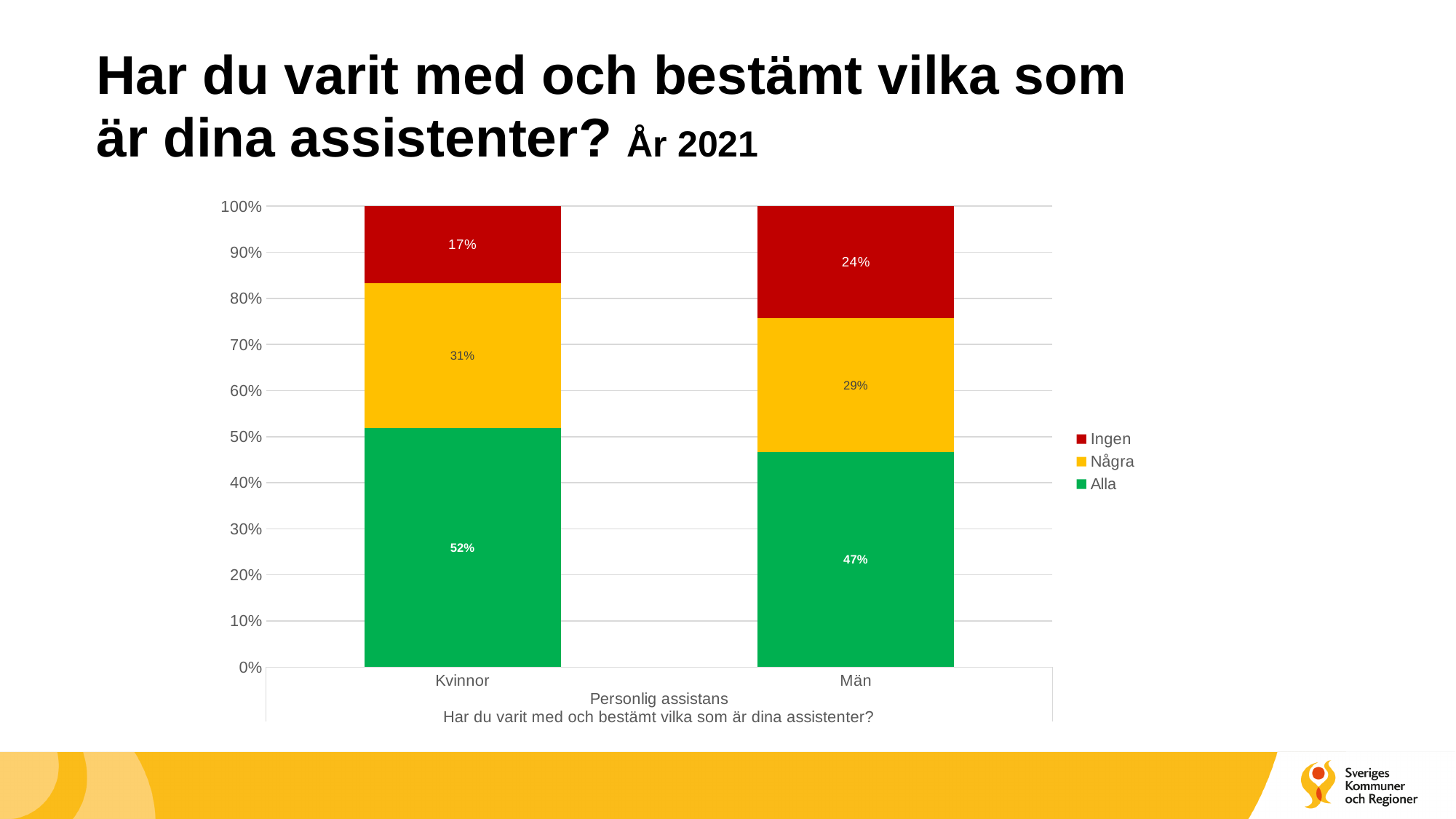
What percentage of Män answered Ingen? 24% What percentage of Kvinnor answered Alla? 52% How many categories are shown on the x axis? 2 What kind of chart is shown on the slide? Stacked bar chart Which group has the higher share answering Ingen, Kvinnor or Män? Män Which group has the higher share answering Alla, Kvinnor or Män? Kvinnor What percentage of Män answered Alla? 47% Which colour represents the Några series in the legend? Yellow What is the difference in percentage points between the Ingen share for Män and for Kvinnor? 7 What percentage of Kvinnor answered Några? 31% How many series does the legend list? 3 What is the difference in percentage points between the Alla share for Kvinnor and for Män? 5